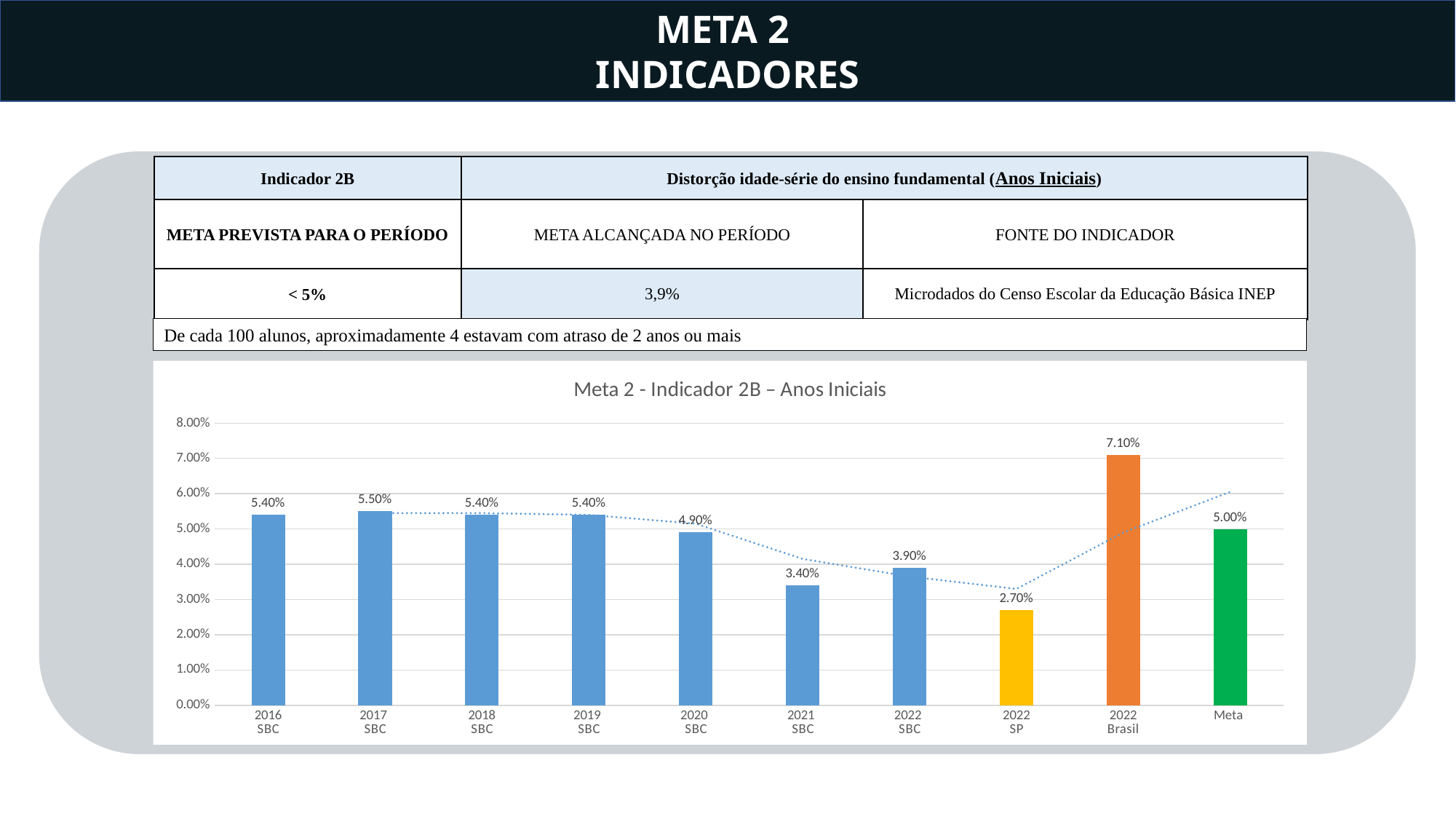
What is the title of the chart? Meta 2 - Indicador 2B – Anos Iniciais What is the difference between 2022 Brasil and 2022 SBC? 3.20% What is the value for 2021 SBC? 3.40% What is the value of the Meta bar? 5.00% Which is larger, the value for 2017 SBC or the value for 2020 SBC? 2017 SBC Is the value for 2022 SBC greater or less than 5.00%? less What is the value for 2022 SP? 2.70% What is the value for 2022 Brasil? 7.10% Which category has the highest value? 2022 Brasil Which category has the lowest value? 2022 SP What kind of chart is this? bar chart How many bars are shown in the chart? 10